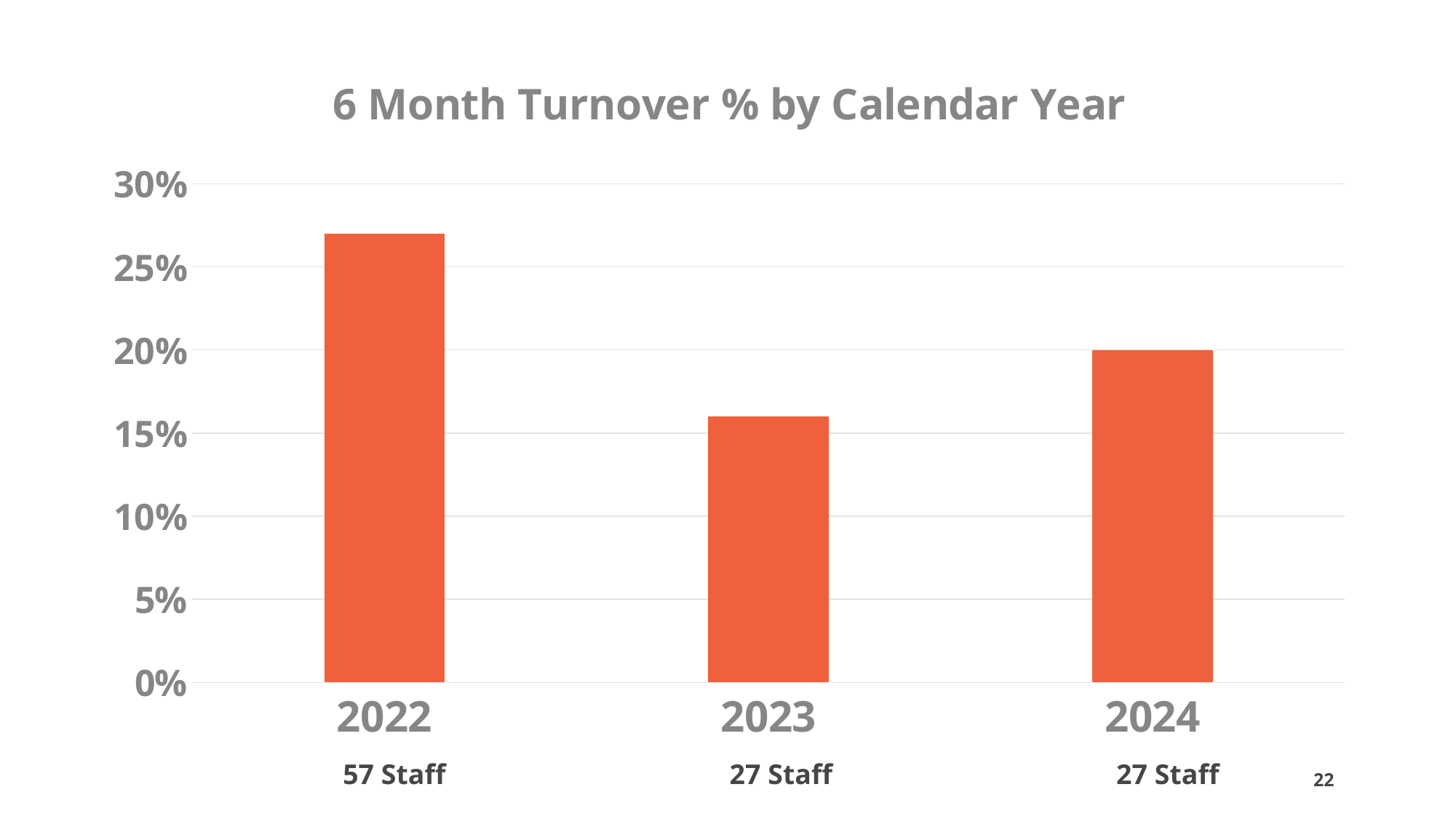
Which year has a higher turnover %, 2023 or 2024? 2024 Does the turnover % rise or fall from 2022 to 2023? fall Which year has a higher turnover %, 2022 or 2024? 2022 What is the title of the chart? 6 Month Turnover % by Calendar Year What is the 6 month turnover % for 2024? 20% Is the turnover % for 2023 greater or less than 20%? less What kind of chart is shown on the slide? bar chart Which year has the lowest 6 month turnover %? 2023 How many years are shown on the x axis of the chart? 3 Is the turnover % for 2022 greater or less than 25%? greater Which year has the highest 6 month turnover %? 2022 Is the turnover % for 2023 greater or less than 15%? greater